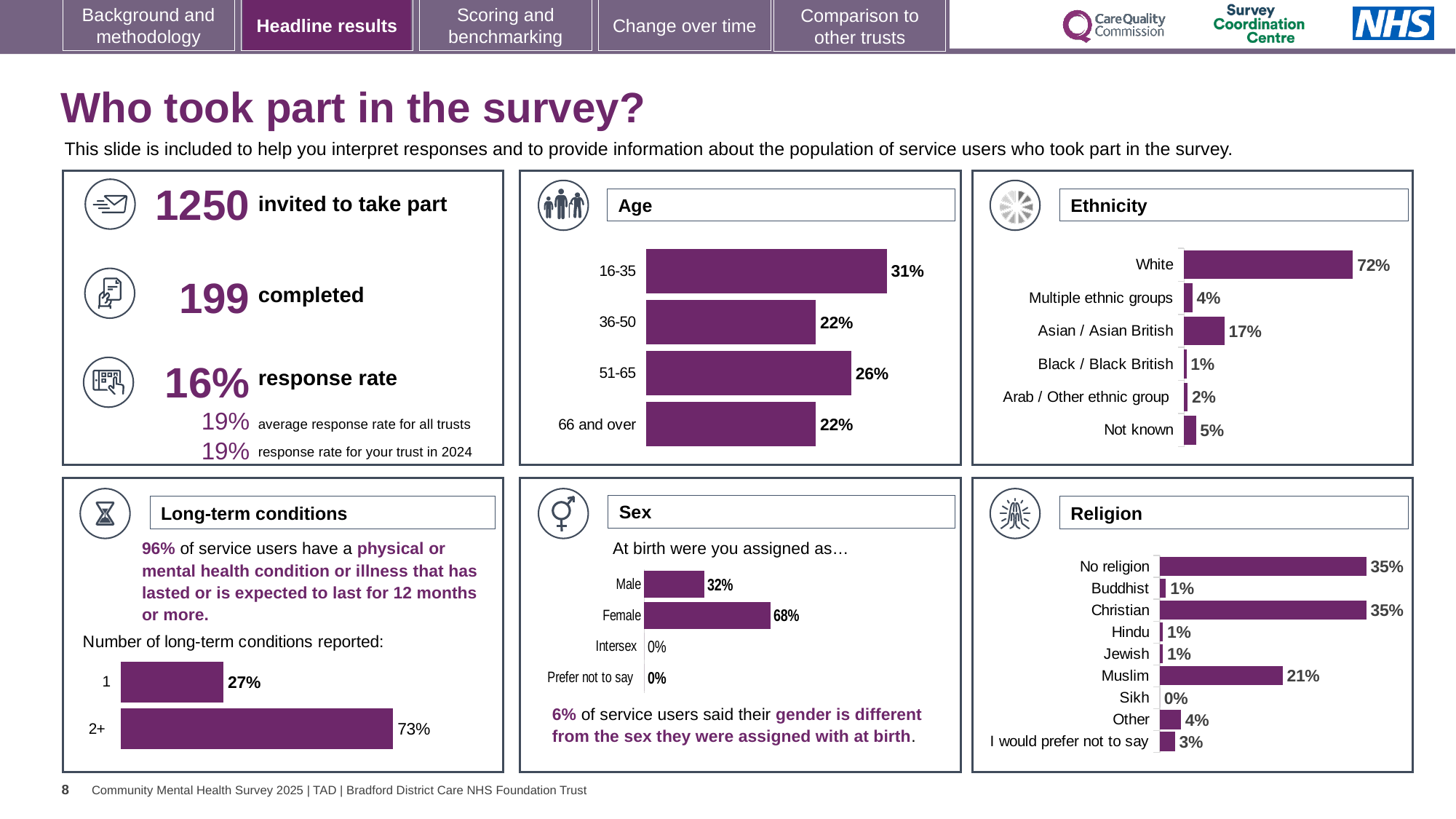
In the Age chart, what percentage of respondents were aged 16-35? 31% In the Religion chart, how many religion categories are listed? 9 In the Sex chart, what percentage of respondents were assigned Female at birth? 68% In the Ethnicity chart, what percentage of respondents were Asian / Asian British? 17% In the Long-term conditions chart, what percentage of service users reported 2+ long-term conditions? 73% In the Sex chart, which is larger, Male or Female? Female In the Age chart, how many age categories are shown? 4 In the Age chart, which age group has the highest percentage? 16-35 In the Ethnicity chart, which category has the lowest percentage? Black / Black British In the Ethnicity chart, what is the difference between the White and Asian / Asian British percentages? 55% In the Religion chart, what percentage of respondents were Muslim? 21% What type of chart is used in the Ethnicity panel? Bar chart